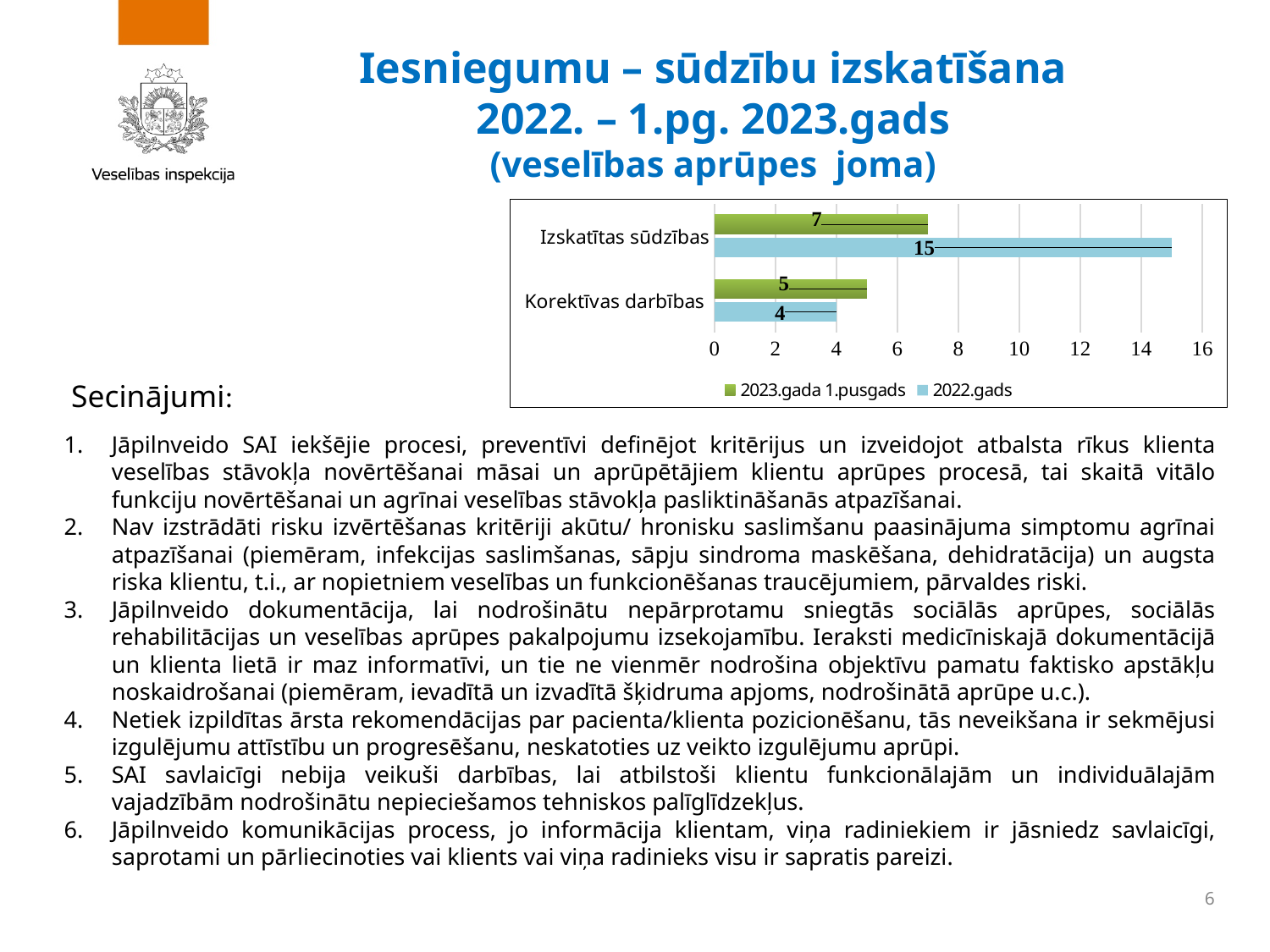
Which category has the highest value in the 2022.gads series? Izskatītas sūdzības What is the value for Izskatītas sūdzības in the 2023.gada 1.pusgads series? 7 Which colour represents the 2022.gads series in the chart? blue What is the value for Izskatītas sūdzības in the 2022.gads series? 15 For Korektīvas darbības, which series has the larger value: 2022.gads or 2023.gada 1.pusgads? 2023.gada 1.pusgads What is the value for Korektīvas darbības in the 2022.gads series? 4 What is the difference between the 2022.gads and 2023.gada 1.pusgads values for Izskatītas sūdzības? 8 How many series does the chart legend list? 2 Which category has the lowest value in the 2023.gada 1.pusgads series? Korektīvas darbības How many categories are shown on the chart? 2 What is the value for Korektīvas darbības in the 2023.gada 1.pusgads series? 5 What type of chart is shown on the slide? bar chart